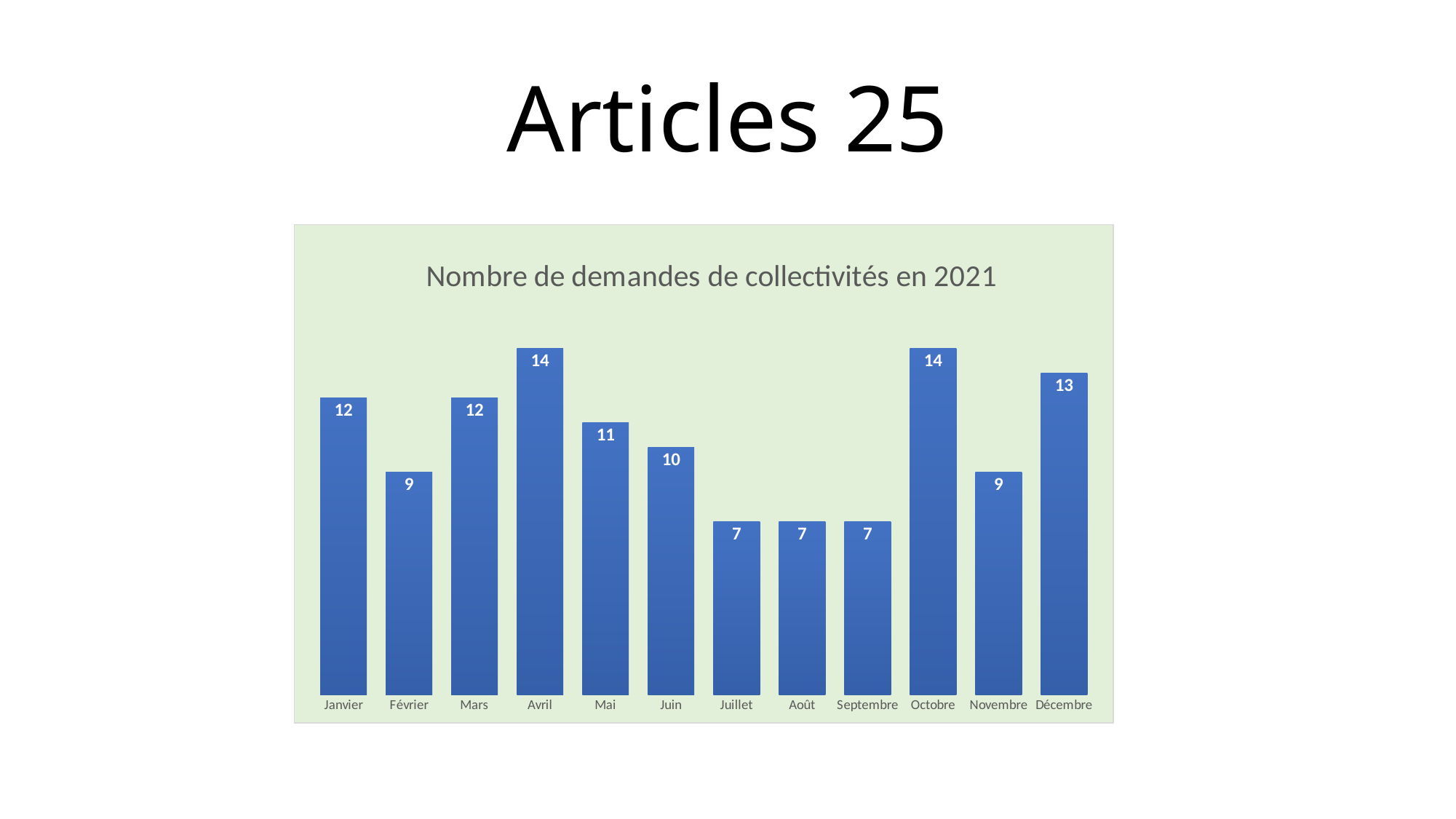
What is the title of the chart? Nombre de demandes de collectivités en 2021 Which two months share the highest value in the chart? Avril and Octobre What is the value for Décembre? 13 Which is larger, the value for Mai or the value for Novembre? Mai Do the values rise or fall from Avril to Juillet? fall Which months share the lowest value in the chart? Juillet, Août and Septembre What type of chart is shown on the slide? bar chart What is the value for Avril? 14 What is the value for Février? 9 How many months are shown on the x axis of the chart? 12 What is the difference between the values for Avril and Juillet? 7 What is the value for Juin? 10